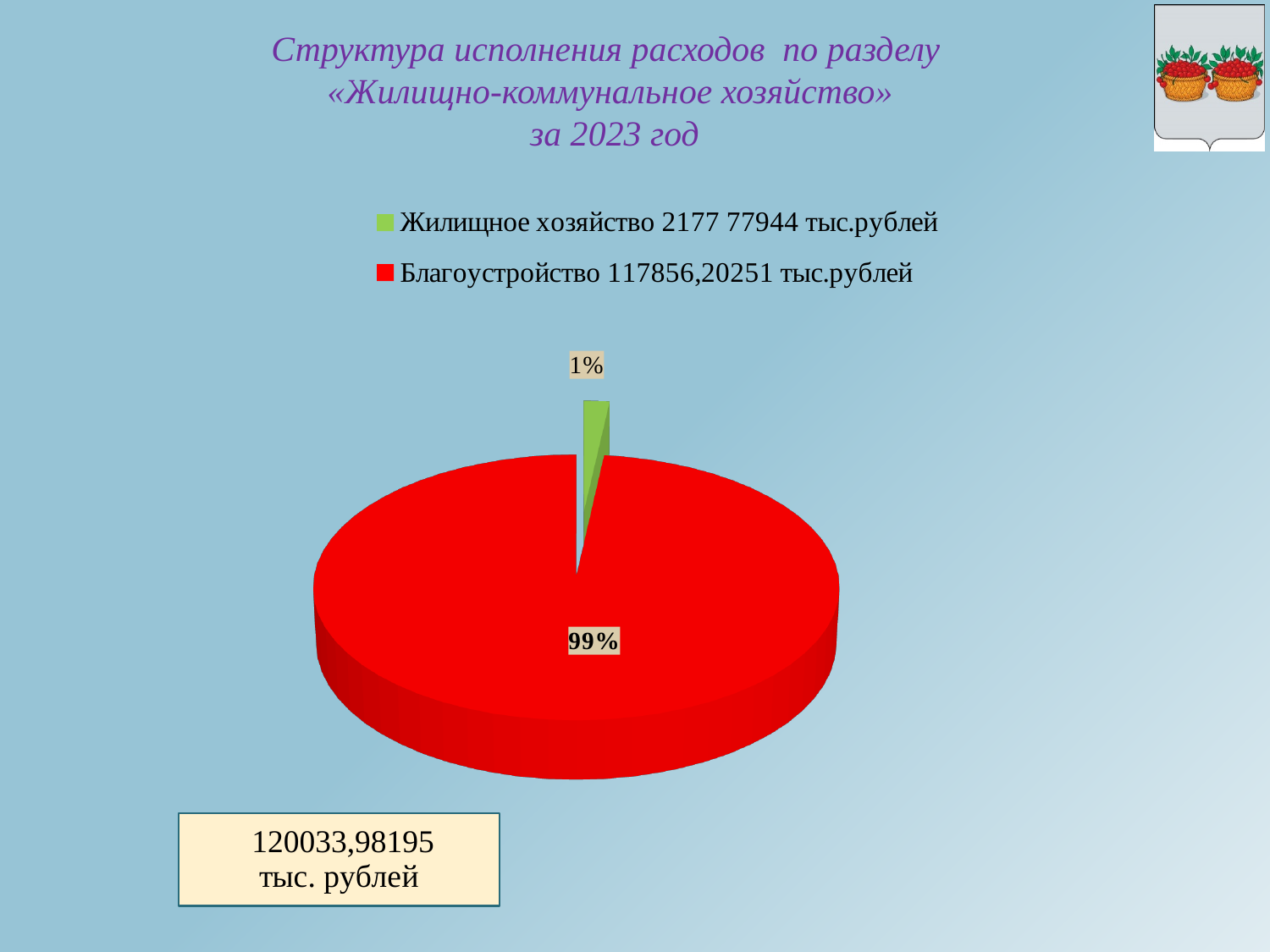
Which category has the smallest slice of the pie? Жилищное хозяйство Which is larger, the share for Благоустройство or the share for Жилищное хозяйство? Благоустройство What amount is shown in the legend for Благоустройство? 117856,20251 тыс.рублей By how many percentage points does the share of Благоустройство exceed the share of Жилищное хозяйство? 98 percentage points What kind of chart is shown on the slide? pie chart How many slices does the pie chart have? 2 What share of the pie does Благоустройство account for? 99% What colour is the slice for Жилищное хозяйство? green How many entries does the legend list? 2 Which category has the largest slice of the pie? Благоустройство What year does the chart title say the data is for? 2023 What share of the pie does Жилищное хозяйство account for? 1%